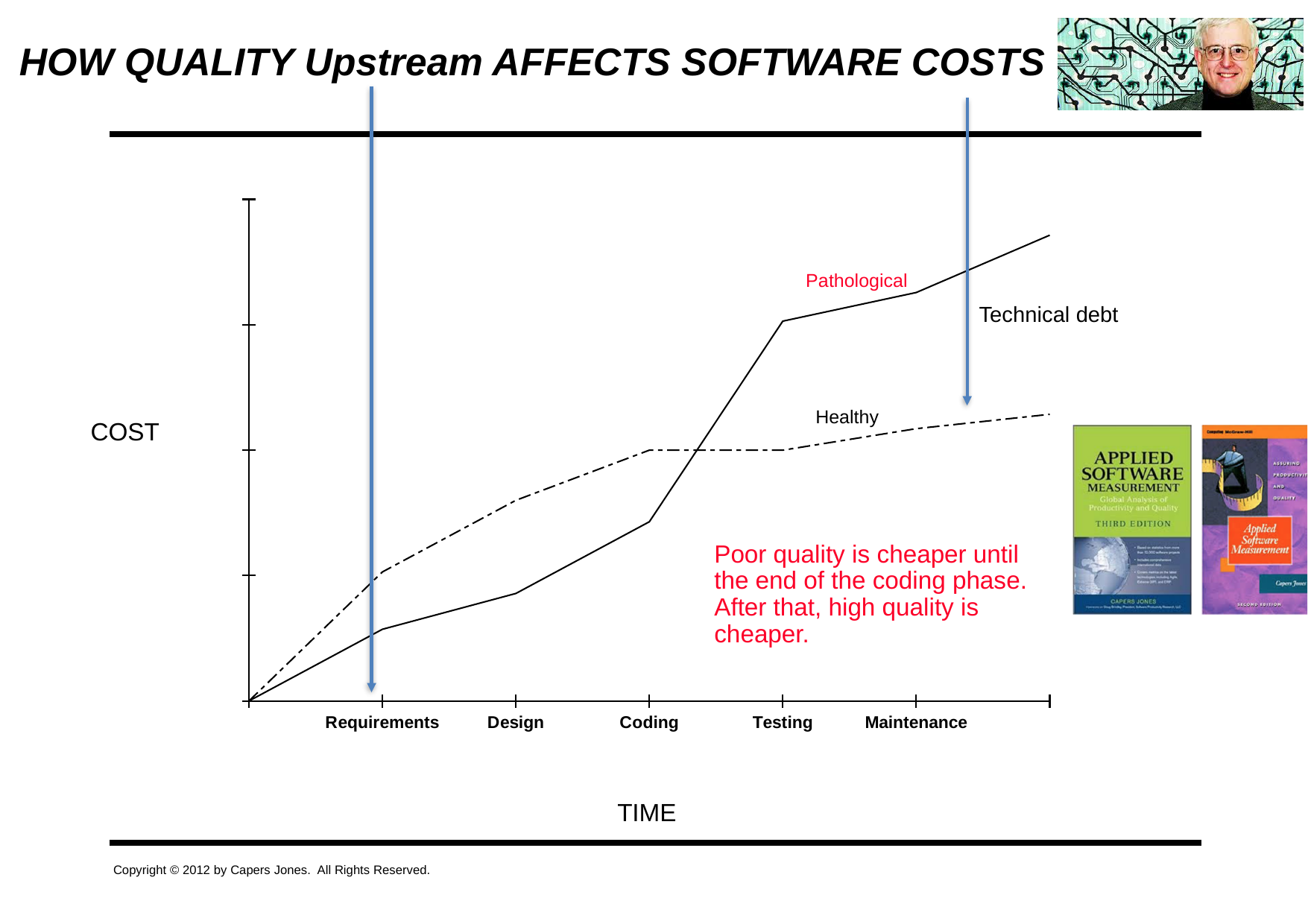
At the Maintenance phase, which line is higher, Pathological or Healthy? Pathological Does the Pathological line rise or fall as time moves from Requirements to Maintenance? Rise What kind of chart is shown on the slide? Line chart What is the label on the vertical axis of the chart? COST How many lines (series) are plotted on the chart? 2 At the Requirements phase, which line is higher, Pathological or Healthy? Healthy Does the Healthy line rise or fall across the TIME axis? Rise At the Testing phase, which line shows the higher cost, Pathological or Healthy? Pathological What are the names of the two lines plotted on the chart? Pathological and Healthy Which line reaches the highest cost at the right end of the chart? Pathological How many phases are labelled along the TIME axis of the chart? 5